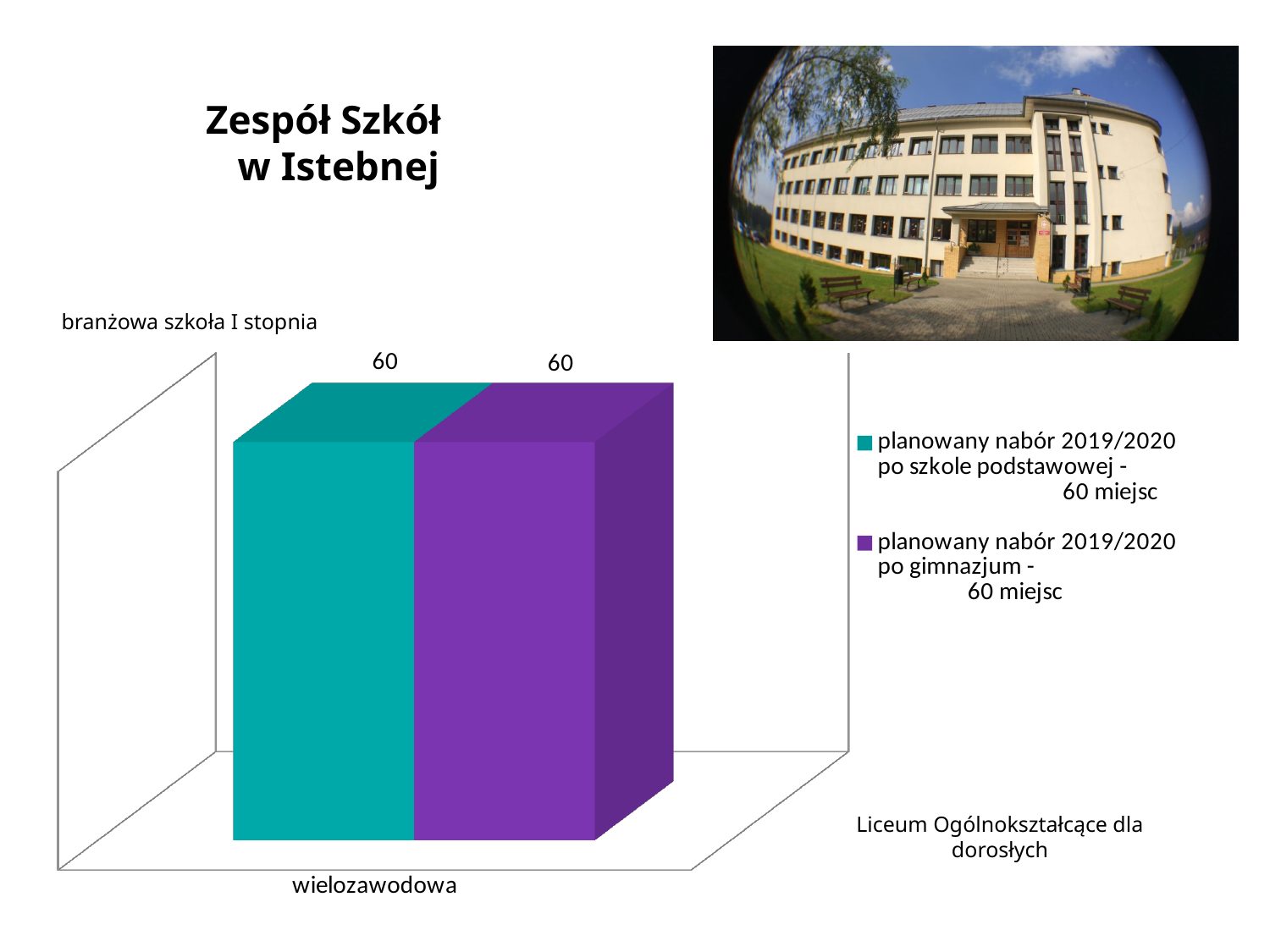
What is the title of the chart? branżowa szkoła I stopnia What is the difference between the 'po szkole podstawowej' value and the 'po gimnazjum' value for 'wielozawodowa'? 0 Which colour represents the series 'planowany nabór 2019/2020 po gimnazjum' in the chart? purple How many series does the chart legend list? 2 How many categories are shown on the x axis of the chart? 1 What is the label of the single category on the x axis of the chart? wielozawodowa What is the value for 'planowany nabór 2019/2020 po gimnazjum' for the category 'wielozawodowa'? 60 What is the value for 'planowany nabór 2019/2020 po szkole podstawowej' for the category 'wielozawodowa'? 60 What kind of chart is shown on the slide? bar chart